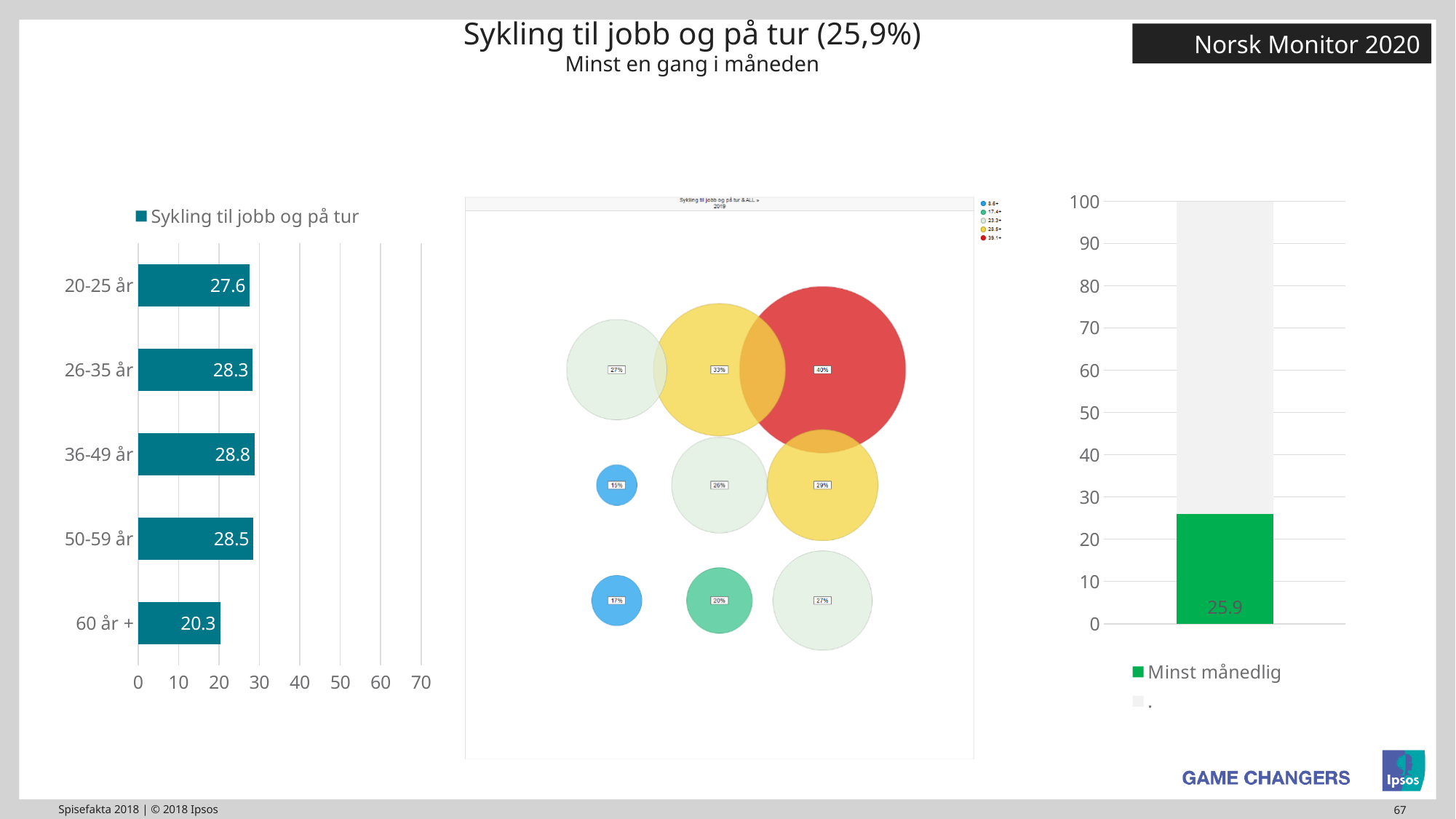
In the left bar chart, what is the value for 36-49 år? 28.8 In the left bar chart, which age group has the highest value? 36-49 år What kind of chart is the chart on the left of the slide? Bar chart How many age groups are shown in the left bar chart? 5 What is the legend entry of the left bar chart? Sykling til jobb og på tur In the left bar chart, which is larger: the value for 20-25 år or the value for 50-59 år? 50-59 år In the left bar chart, what is the value for 60 år +? 20.3 In the left bar chart, what is the difference between the values for 26-35 år and 60 år +? 8.0 In the middle bubble chart, what is the highest percentage shown in a bubble? 40% In the left bar chart, which age group has the lowest value? 60 år + In the right chart, what is the value for Minst månedlig? 25.9 In the right chart, is the value for Minst månedlig greater or less than 30? less